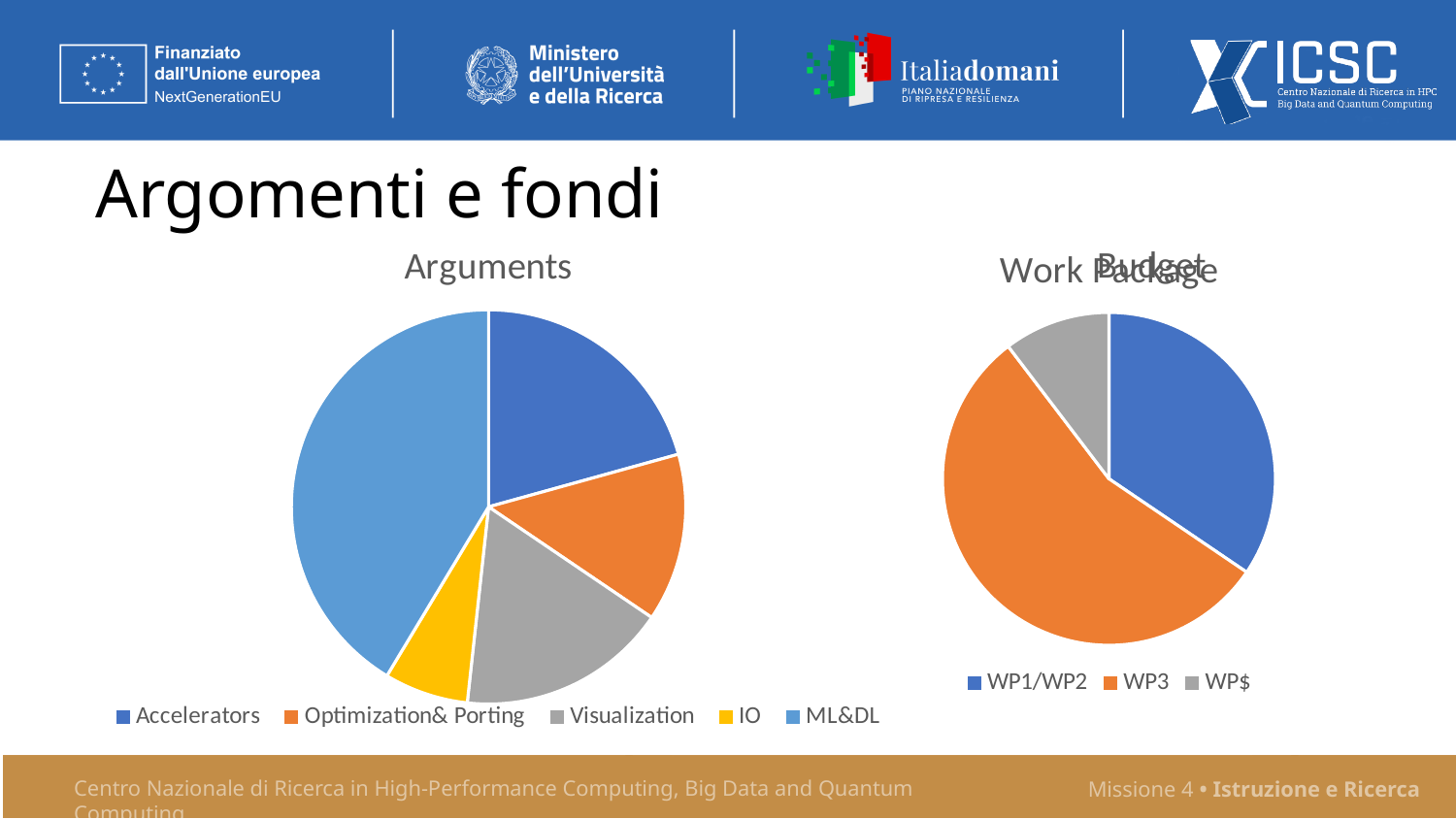
What kind of chart is the chart on the right of the slide? pie chart In the left chart titled "Arguments", which category has the largest slice? ML&DL In the chart on the right of the slide, which category has the smallest slice? WP$ In the chart on the right of the slide, what are the legend entries? WP1/WP2, WP3, WP$ In the left chart titled "Arguments", which slice is larger, Accelerators or IO? Accelerators In the left chart titled "Arguments", which category has the smallest slice? IO In the chart on the right of the slide, how many slices does the pie have? 3 In the left chart titled "Arguments", how many slices does the pie have? 5 In the left chart titled "Arguments", what colour is the ML&DL slice? light blue What kind of chart is the left chart titled "Arguments"? pie chart In the chart on the right of the slide, which category has the largest slice? WP3 In the chart on the right of the slide, which slice is larger, WP1/WP2 or WP$? WP1/WP2